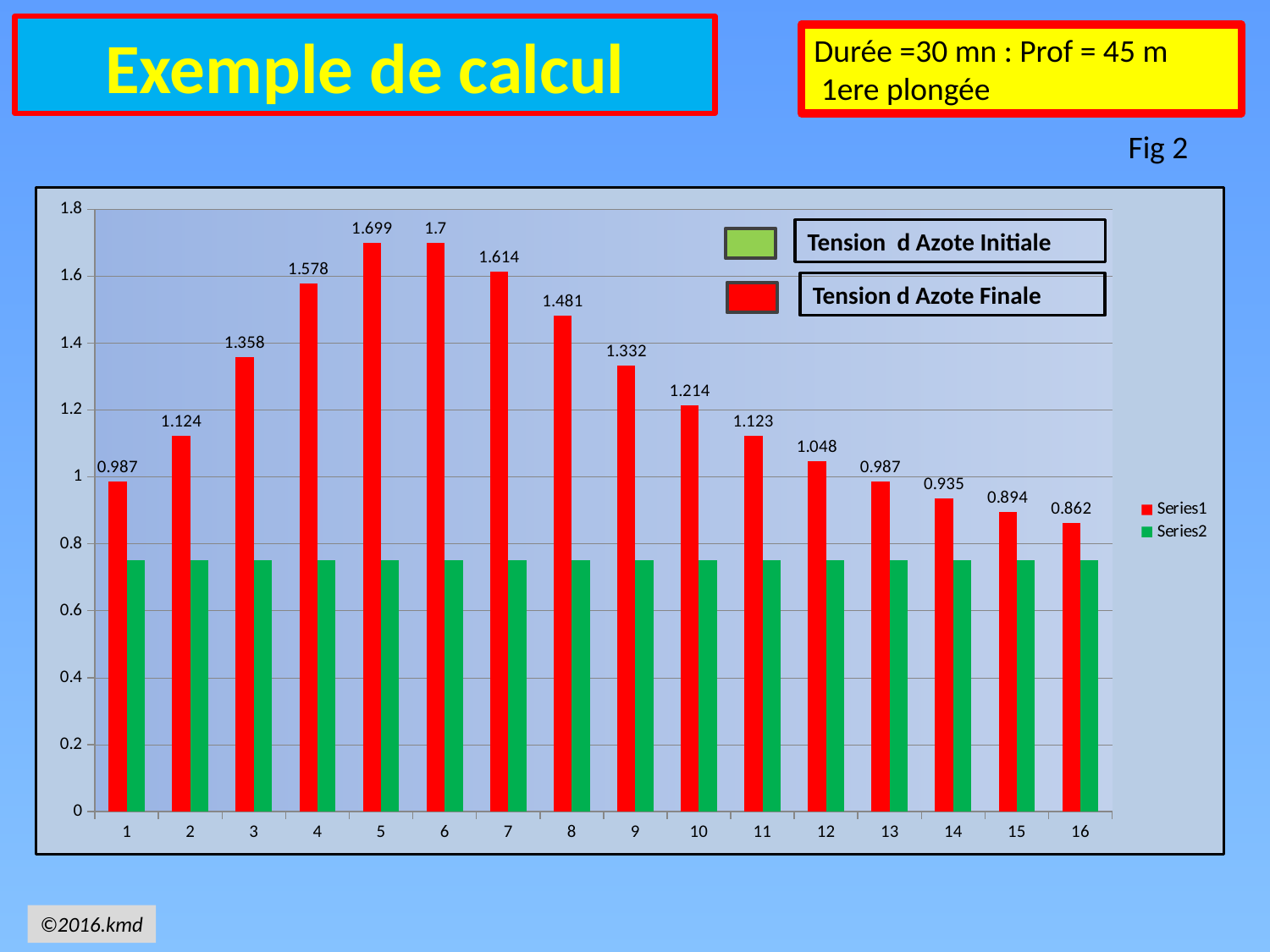
Do the Series1 values rise or fall from category 6 to category 16? fall What is the value of Series1 for category 1? 0.987 What type of chart is shown on the slide? bar chart What is the value of Series1 for category 6? 1.7 Which category has the lowest Series1 value? 16 How many series does the chart legend list? 2 Which category has the highest Series1 value? 6 What is the value of Series1 for category 12? 1.048 Is the Series2 value for category 1 greater or less than 1? less What is the difference between the Series1 values for category 4 and category 3? 0.22 Which is larger, the Series1 value for category 9 or for category 10? category 9 How many categories are shown on the x axis of the chart? 16